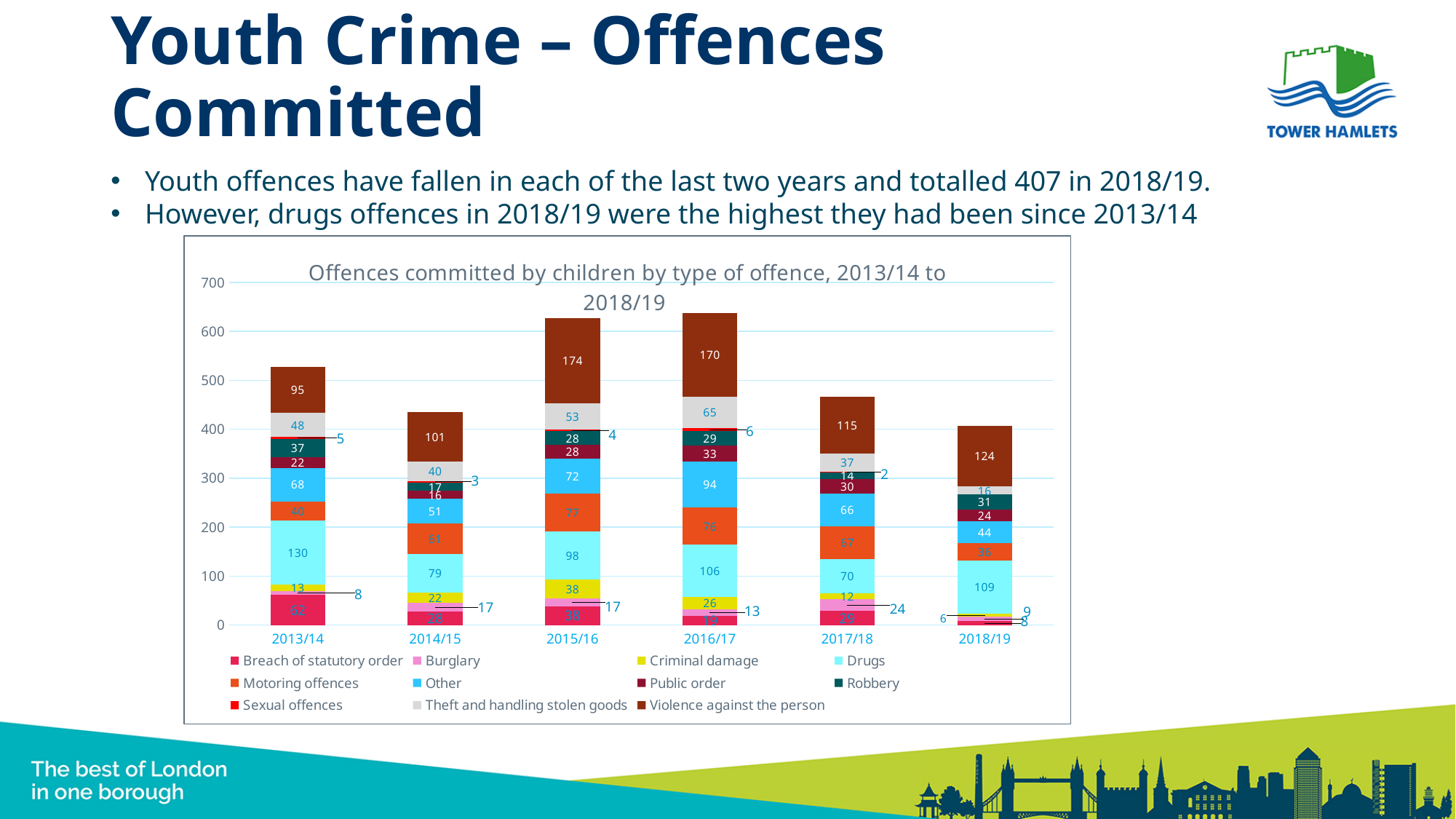
What is the value for Drugs in 2013/14? 130 How many series does the chart's legend list? 11 In which year is the Violence against the person value highest? 2015/16 What is the value for Violence against the person in 2018/19? 124 What is the difference between the Violence against the person values for 2015/16 and 2016/17? 4 In which year is the Drugs value lowest? 2017/18 Is the total height of the 2017/18 bar greater or less than 500? less What is the value for Other in 2016/17? 94 What is the title of the chart? Offences committed by children by type of offence, 2013/14 to 2018/19 How many years (categories) are shown on the x axis of the chart? 6 Which is larger: Motoring offences in 2014/15 or Motoring offences in 2018/19? 2014/15 What type of chart is shown on the slide? Stacked bar chart